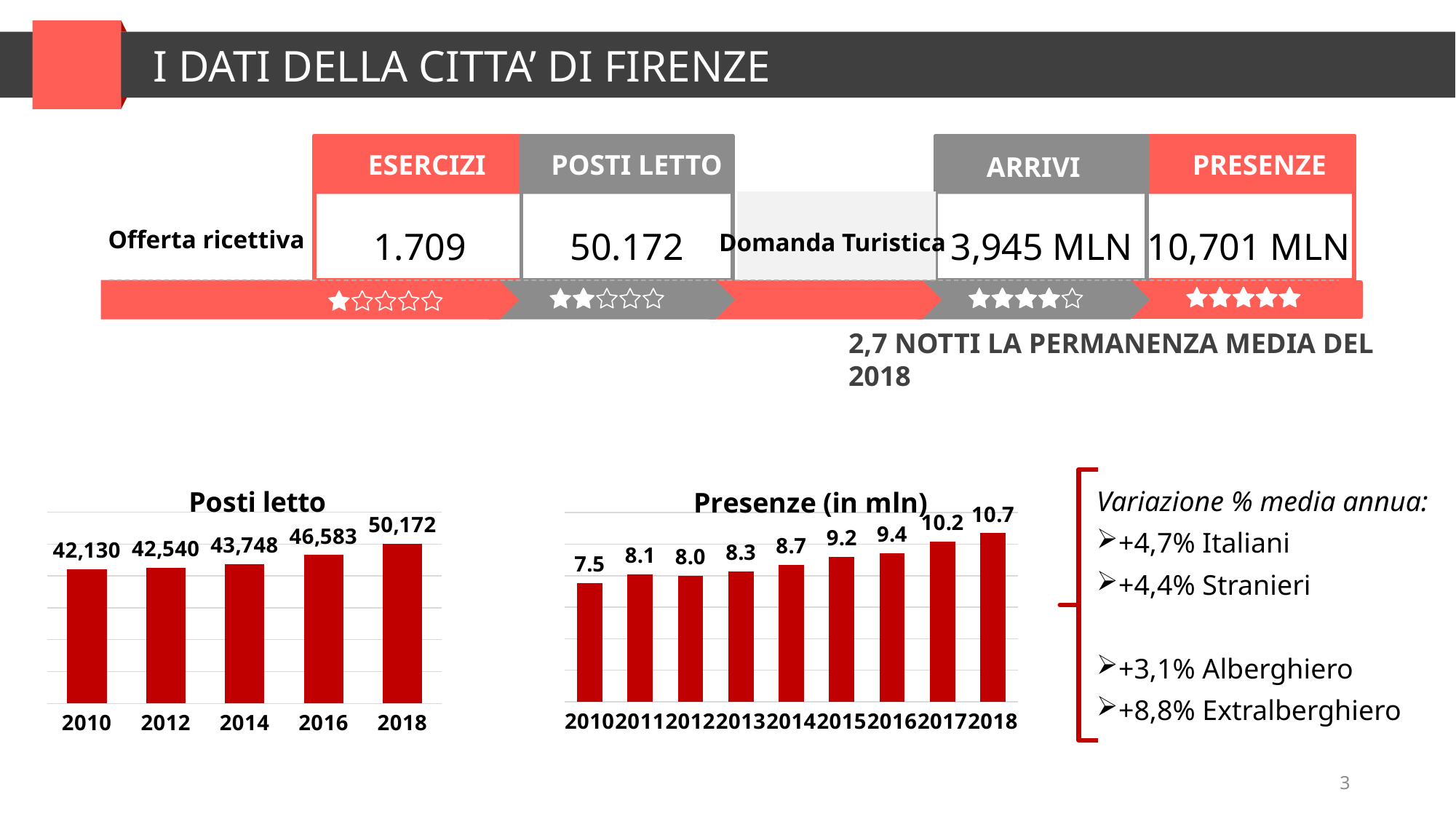
In the 'Posti letto' chart, do the values rise or fall from 2010 to 2018? rise In the 'Posti letto' chart, what is the value for 2014? 43,748 In the 'Presenze (in mln)' chart, what is the value for 2015? 9.2 How many bars are shown in the 'Posti letto' chart? 5 In the 'Presenze (in mln)' chart, which year has the lowest value? 2010 What type of chart is the 'Presenze (in mln)' chart? bar chart In the 'Presenze (in mln)' chart, what is the difference between the values for 2018 and 2010? 3.2 In the 'Posti letto' chart, which year has the lowest value? 2010 In the 'Posti letto' chart, what is the difference between the values for 2018 and 2016? 3,589 In the 'Presenze (in mln)' chart, which is larger, the value for 2011 or the value for 2012? 2011 How many years are shown in the 'Presenze (in mln)' chart? 9 In the 'Posti letto' chart, which year has the highest value? 2018